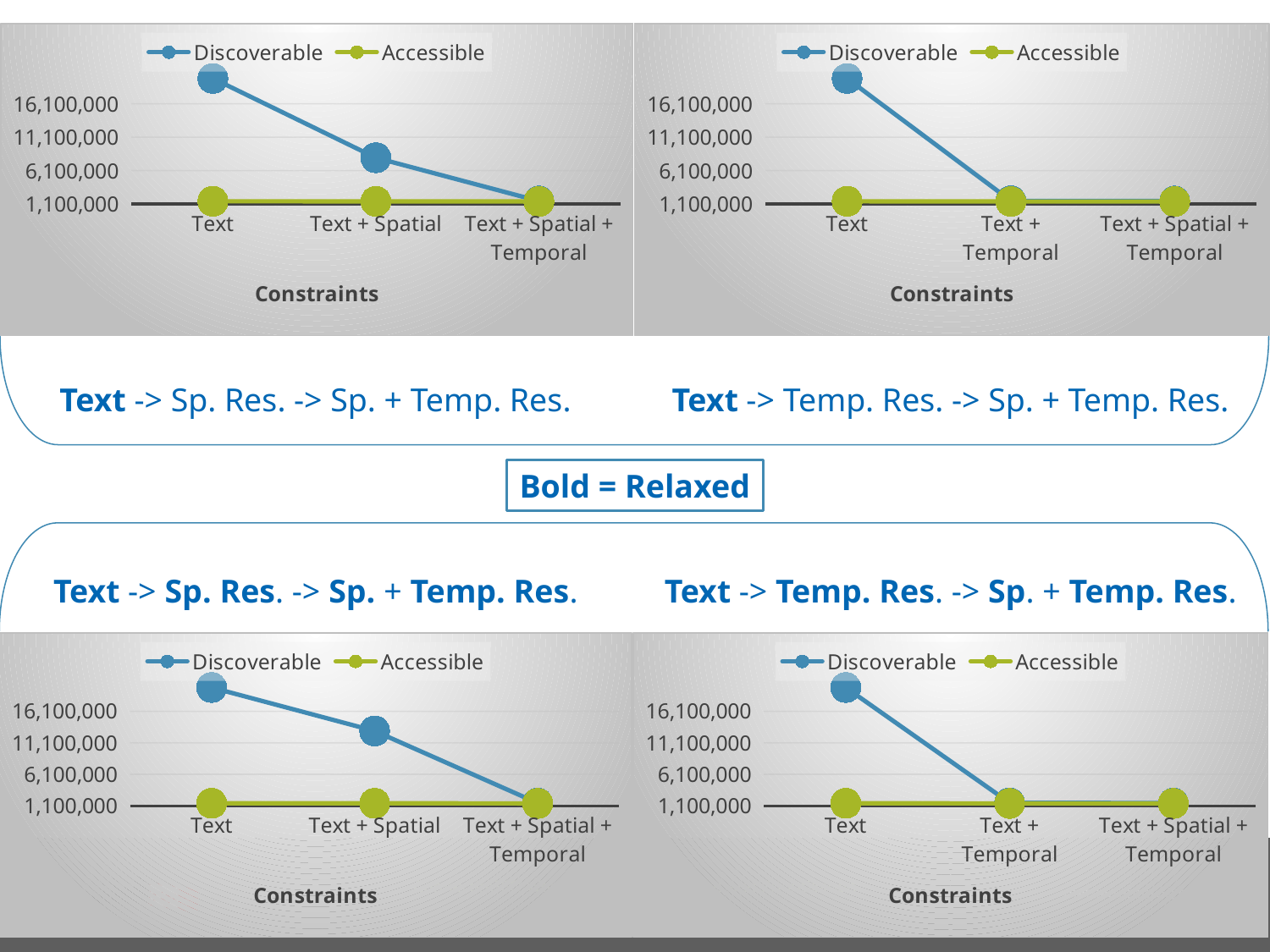
What is the x-axis title of the bottom-right chart? Constraints In the bottom-right chart, is the Discoverable value for Text greater or less than 16,100,000? greater How many series does the legend of the top-left chart list? 2 In the top-left chart, does the Discoverable series rise or fall from Text to Text + Spatial + Temporal? fall In the bottom-left chart, is the Discoverable value for Text + Spatial greater or less than 11,100,000? greater In the top-left chart, is the Discoverable value for Text + Spatial greater or less than 6,100,000? greater What kind of chart is the top-left chart? line chart In the bottom-left chart, which series has the larger value at Text, Discoverable or Accessible? Discoverable In the top-left chart, which category has the highest Discoverable value? Text How many categories are shown on the x axis of the top-right chart? 3